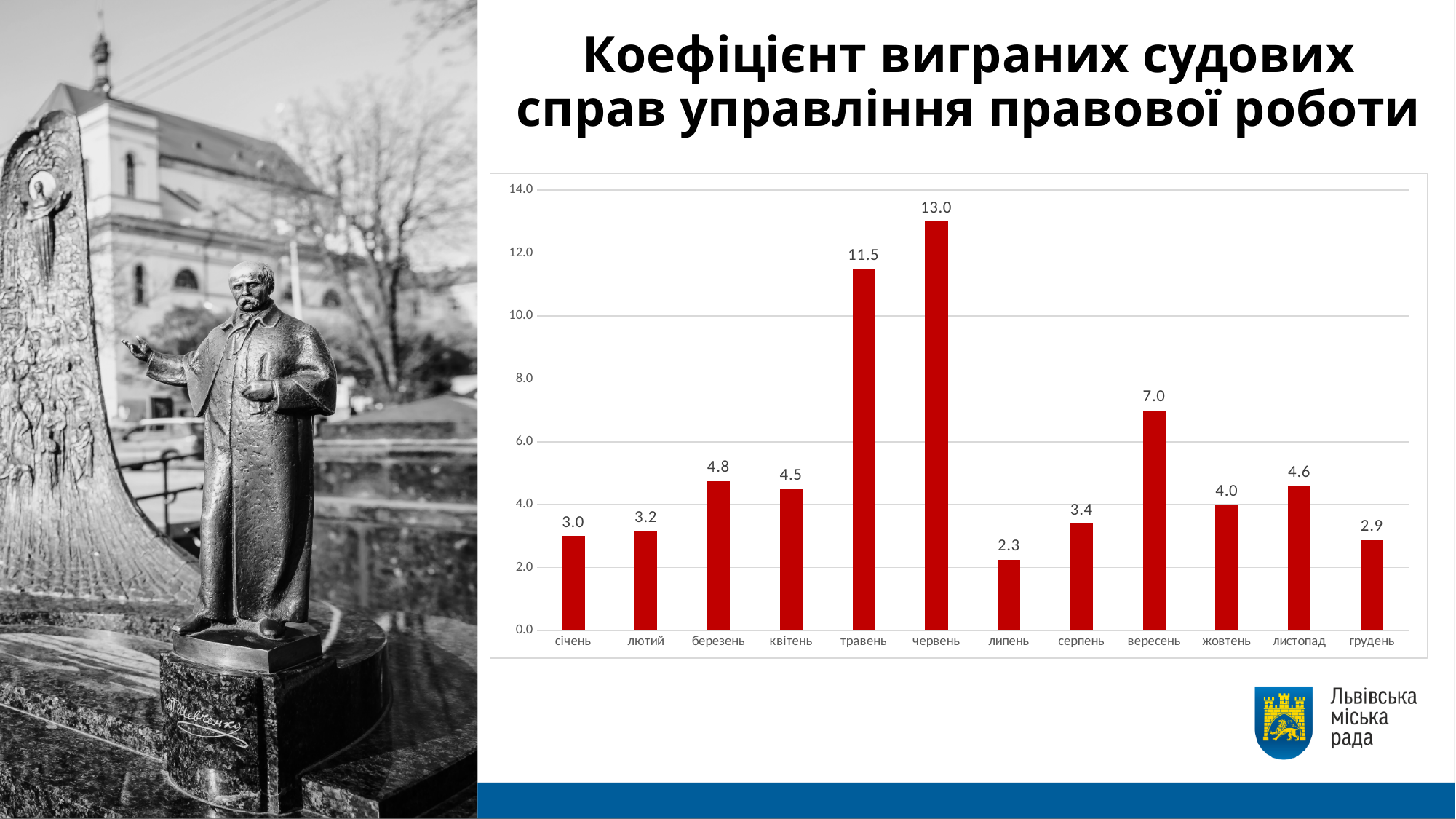
What is the value for червень? 13.0 What kind of chart is shown on the slide? bar chart Is the value for травень greater or less than 10.0? greater Which is larger, the value for березень or the value for квітень? березень What is the difference between the values for червень and травень? 1.5 What is the value for вересень? 7.0 Which month has the highest value? червень Which month has the lowest value? липень What is the title of the chart? Коефіцієнт виграних судових справ управління правової роботи Do the values rise or fall from травень to липень? rise then fall What is the value for липень? 2.3 How many months are shown on the x axis? 12